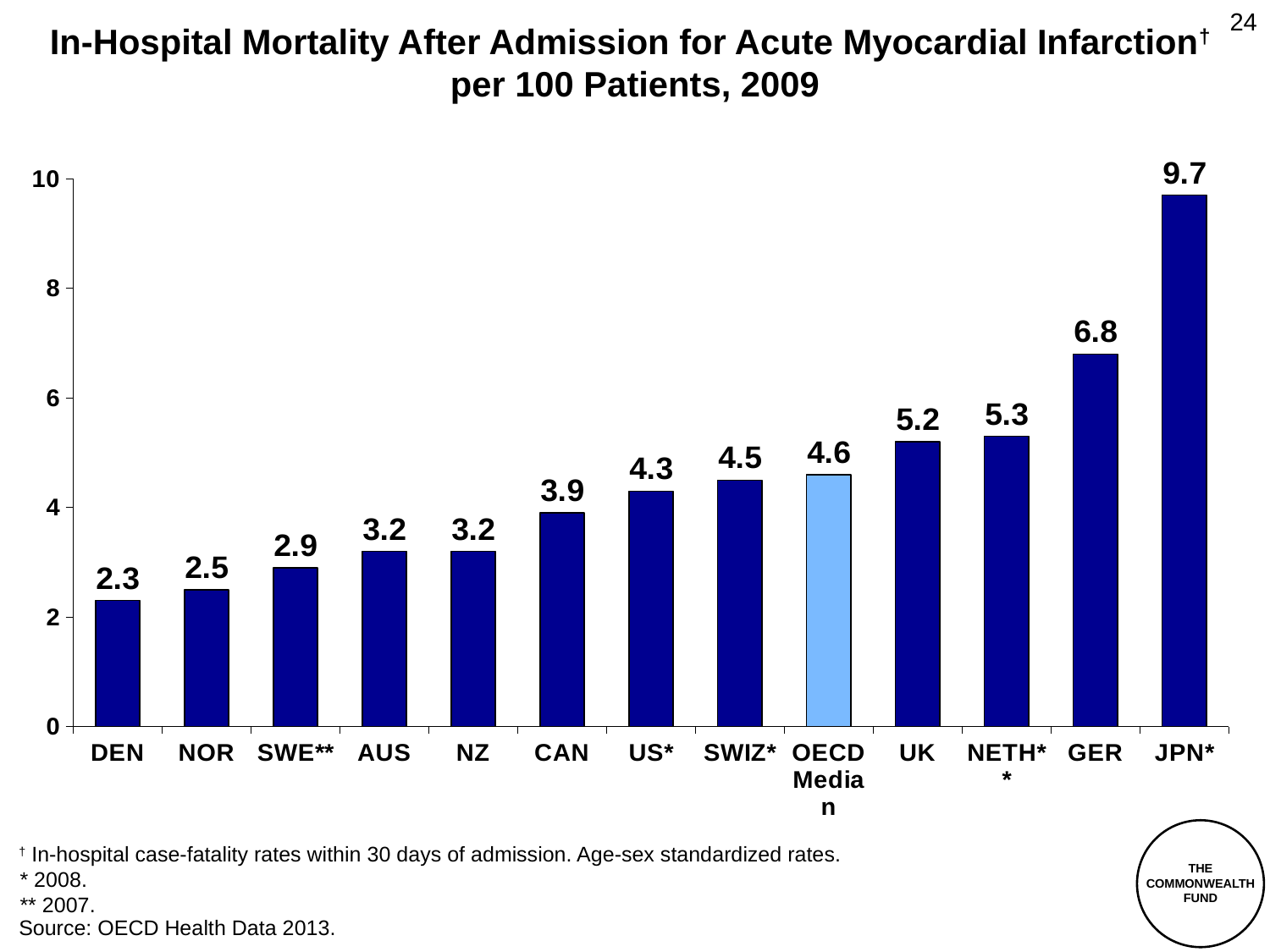
Which country has the lowest in-hospital mortality rate on the chart? DEN Which country has the highest in-hospital mortality rate on the chart? JPN* How many bars are shown on the chart? 13 What is the value shown for the OECD Median bar? 4.6 What is the difference between the values for GER and UK? 1.6 What kind of chart is shown on the slide? Bar chart Is the value for NETH** greater or less than 4? greater What is the value for CAN? 3.9 What is the in-hospital mortality value for JPN*? 9.7 Which has a higher value, US* or SWE**? US* Do the values generally rise or fall from left to right along the x axis? Rise Which bar is shown in a lighter blue colour than the others? OECD Median